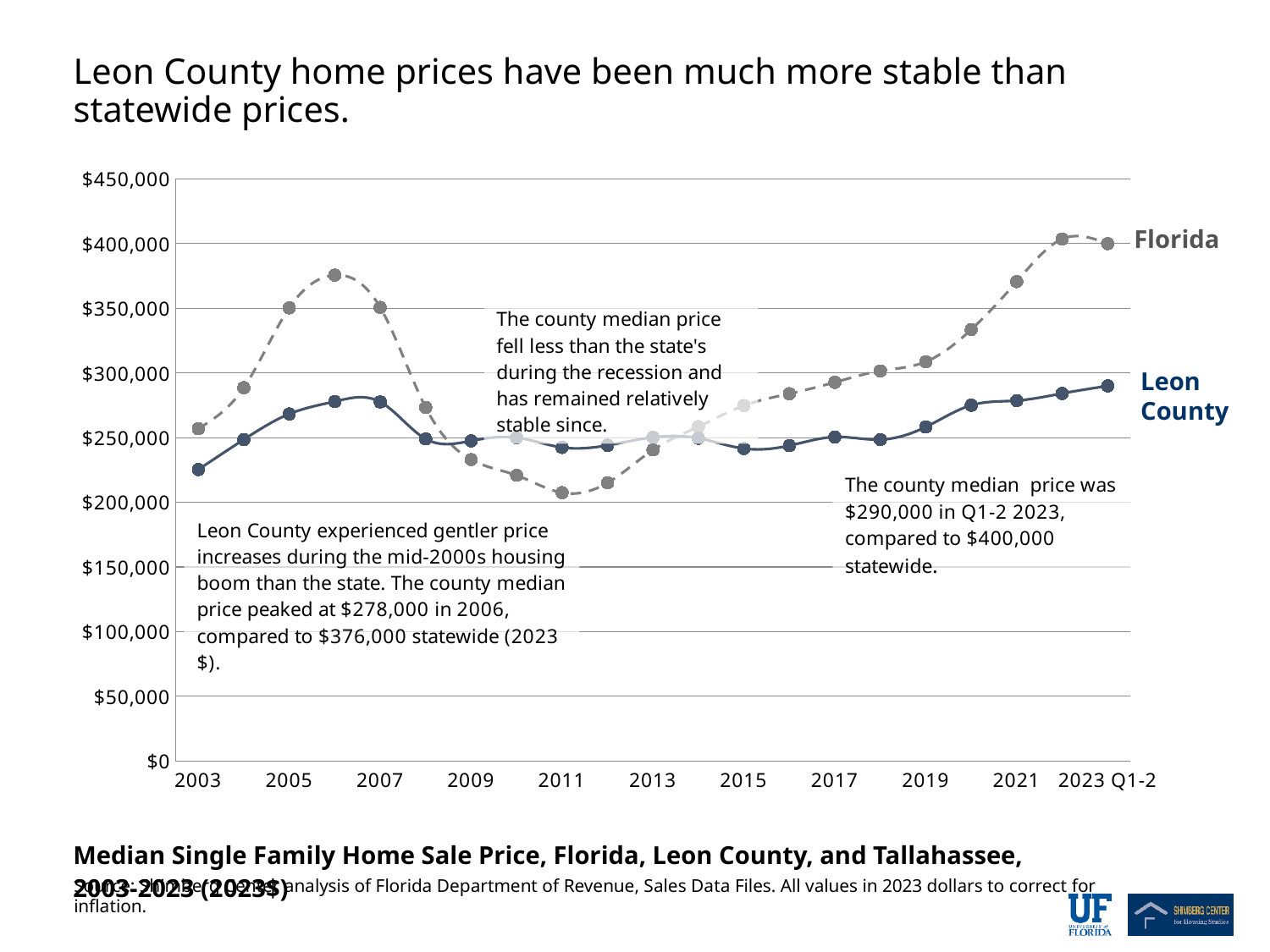
Is the Florida value for 2011 greater or less than $250,000? less What was the Leon County median price in Q1-2 2023? $290,000 In 2011, which series has the higher value, Florida or Leon County? Leon County What is the difference between the statewide and Leon County median prices in Q1-2 2023? $110,000 Which series is drawn with a dashed line? Florida In which year is the Florida series at its lowest? 2011 Is the Leon County value for 2003 greater or less than $250,000? less What is the difference between the statewide and Leon County median prices in 2006? $98,000 According to the slide, what was the statewide median price in 2006? $376,000 How many series are plotted on the chart? 2 According to the slide, what was the Leon County median price at its 2006 peak? $278,000 What kind of chart is shown on the slide? line chart